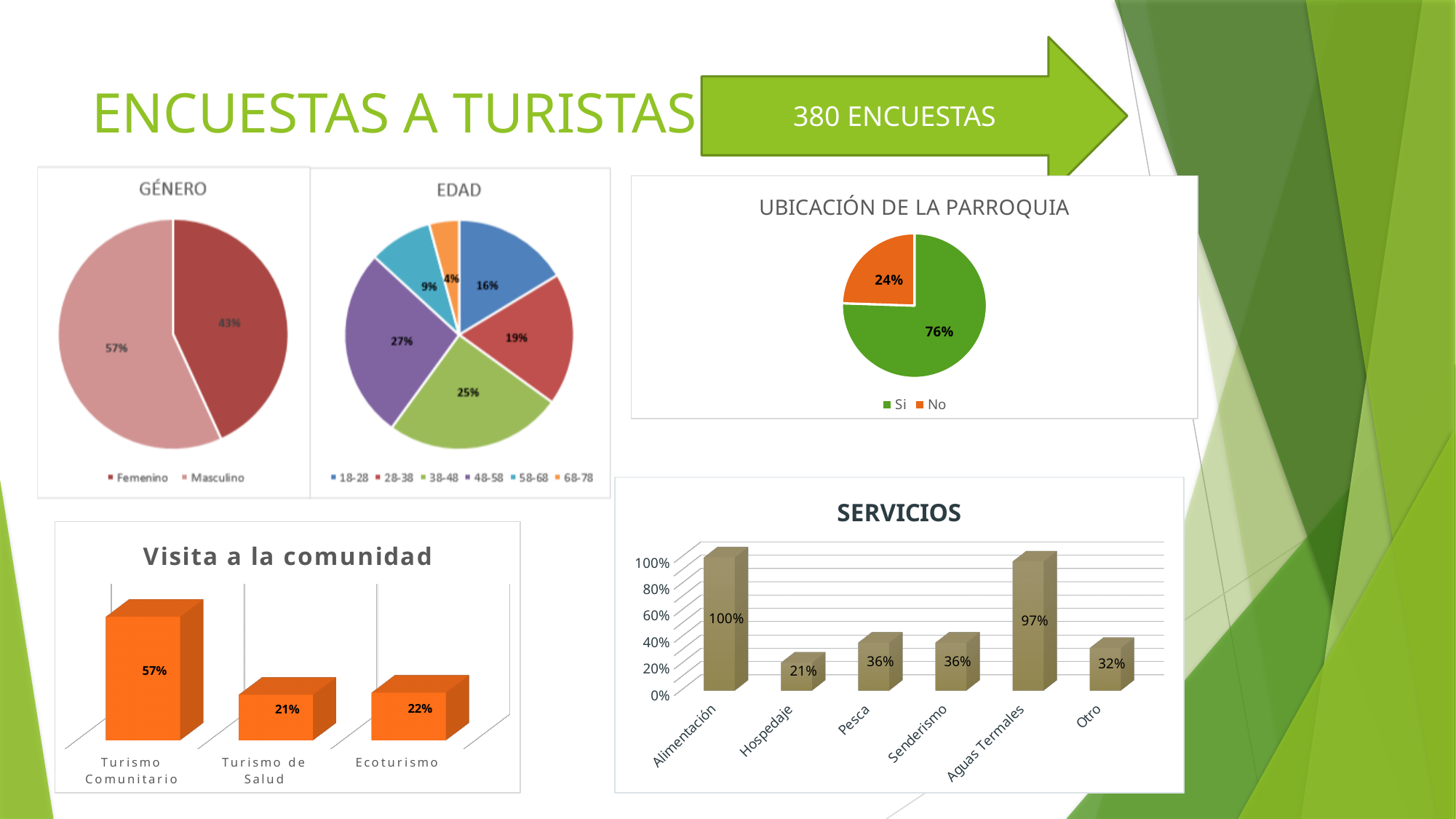
In the UBICACIÓN DE LA PARROQUIA pie chart, what share is No? 24% In the SERVICIOS chart, which category has the lowest value? Hospedaje In the SERVICIOS chart, what is the difference between Alimentación and Otro? 68% In the GÉNERO pie chart, what share is Masculino? 57% How many categories are shown in the SERVICIOS chart? 6 How many entries does the legend of the EDAD pie chart list? 6 In the Visita a la comunidad chart, which is larger, Turismo de Salud or Ecoturismo? Ecoturismo In the SERVICIOS chart, what is the value for Aguas Termales? 97% What type of chart is Visita a la comunidad? Bar chart In the Visita a la comunidad chart, what is the value for Turismo Comunitario? 57% In the EDAD pie chart, which age group has the largest share? 48-58 In the EDAD pie chart, what share is the 58-68 group? 9%